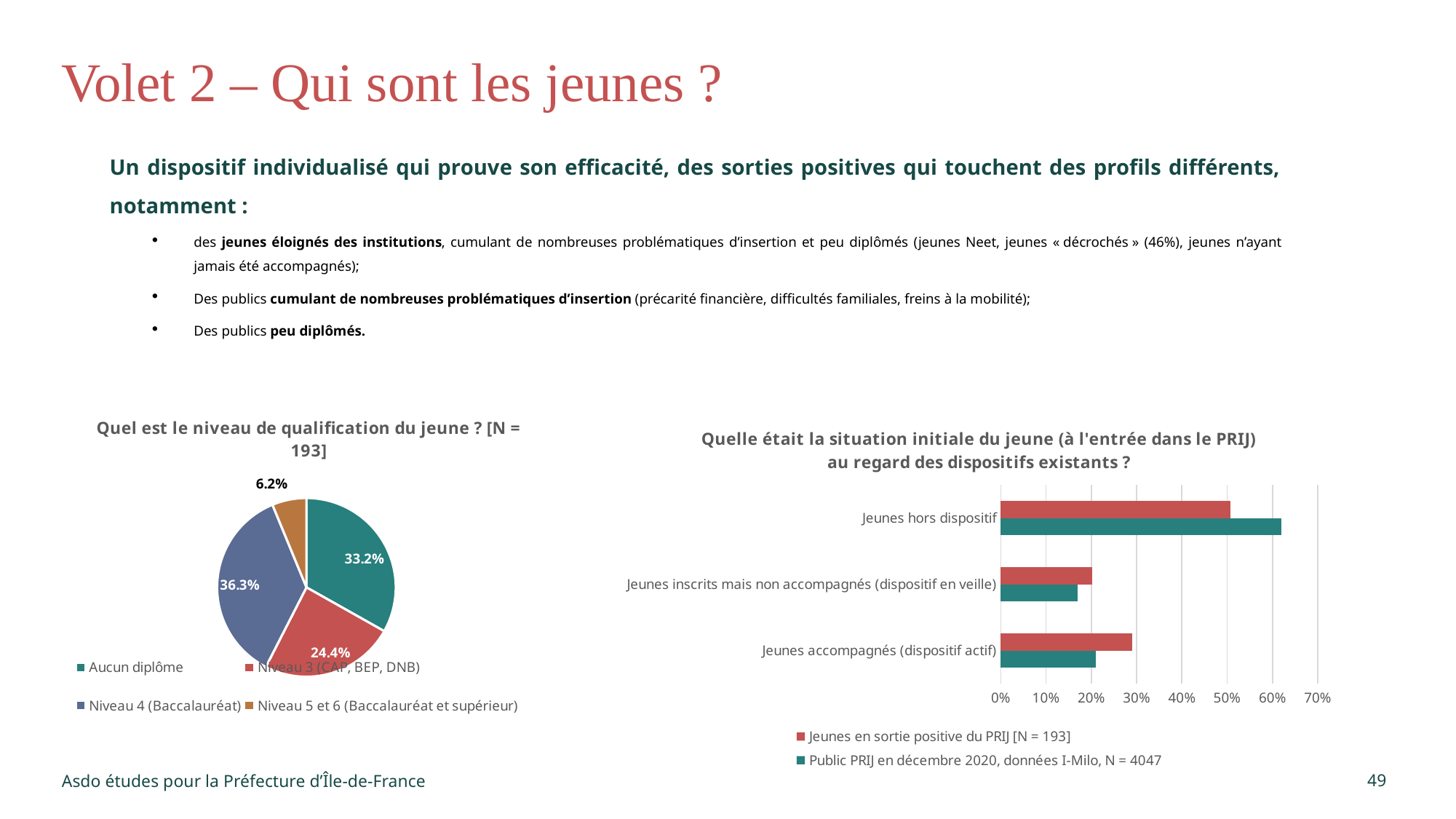
In the pie chart 'Quel est le niveau de qualification du jeune ?', how many slices are there? 4 In the pie chart 'Quel est le niveau de qualification du jeune ?', which category has the smallest share? Niveau 5 et 6 (Baccalauréat et supérieur) In the bar chart 'Quelle était la situation initiale du jeune...', is the value for 'Jeunes accompagnés (dispositif actif)' in the series 'Jeunes en sortie positive du PRIJ [N = 193]' greater or less than 40%? less In the pie chart 'Quel est le niveau de qualification du jeune ?', what share is 'Niveau 4 (Baccalauréat)'? 36.3% In the pie chart 'Quel est le niveau de qualification du jeune ?', what share is 'Niveau 5 et 6 (Baccalauréat et supérieur)'? 6.2% In the bar chart 'Quelle était la situation initiale du jeune...', how many series does the legend list? 2 In the pie chart 'Quel est le niveau de qualification du jeune ?', what is the difference between 'Aucun diplôme' and 'Niveau 3 (CAP, BEP, DNB)'? 8.8% In the bar chart 'Quelle était la situation initiale du jeune...', is the value for 'Jeunes hors dispositif' in the series 'Public PRIJ en décembre 2020, données I-Milo, N = 4047' greater or less than 60%? greater In the bar chart 'Quelle était la situation initiale du jeune...', which category has the highest value for the series 'Jeunes en sortie positive du PRIJ [N = 193]'? Jeunes hors dispositif What kind of chart is 'Quelle était la situation initiale du jeune (à l'entrée dans le PRIJ) au regard des dispositifs existants ?'? Bar chart In the pie chart 'Quel est le niveau de qualification du jeune ?', which category has the largest share? Niveau 4 (Baccalauréat) In the pie chart 'Quel est le niveau de qualification du jeune ?', what share is 'Aucun diplôme'? 33.2%